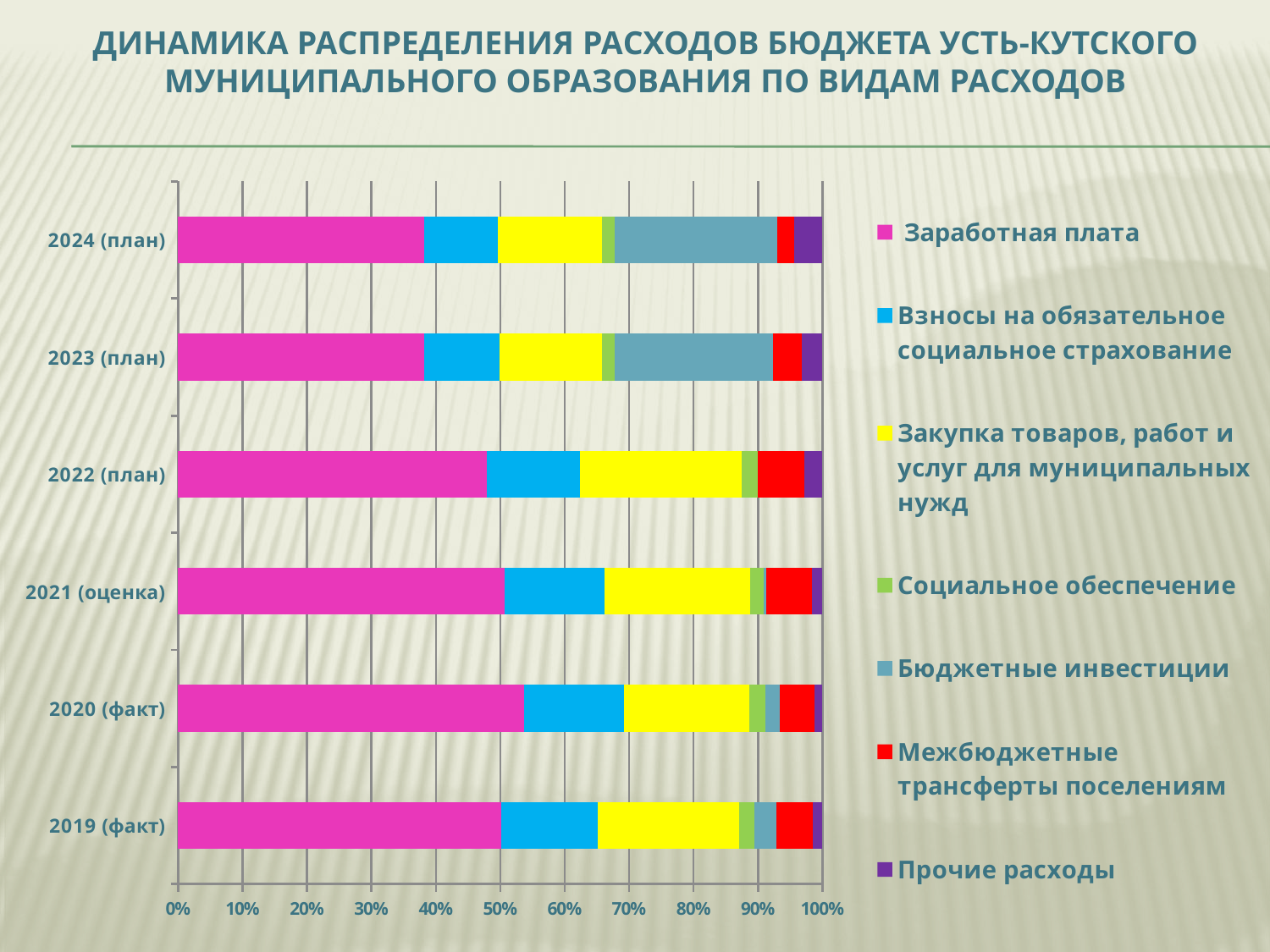
Which has the larger share of Бюджетные инвестиции: 2024 (план) or 2019 (факт)? 2024 (план) What is the title of the chart? Динамика распределения расходов бюджета Усть-Кутского муниципального образования по видам расходов Which series is shown in red in the legend? Межбюджетные трансферты поселениям How many categories (years) are shown on the chart? 6 Is the share of Заработная плата for 2020 (факт) greater or less than 50%? greater How many series does the legend list? 7 Is the share of Заработная плата for 2024 (план) greater or less than 40%? less Which has the larger share of Заработная плата: 2020 (факт) or 2024 (план)? 2020 (факт) Is the share of Заработная плата for 2023 (план) greater or less than 40%? less Which has the larger share of Закупка товаров, работ и услуг для муниципальных нужд: 2022 (план) or 2023 (план)? 2022 (план) What kind of chart is shown on the slide? Stacked bar chart From 2021 (оценка) to 2024 (план), does the share of Заработная плата rise or fall? fall